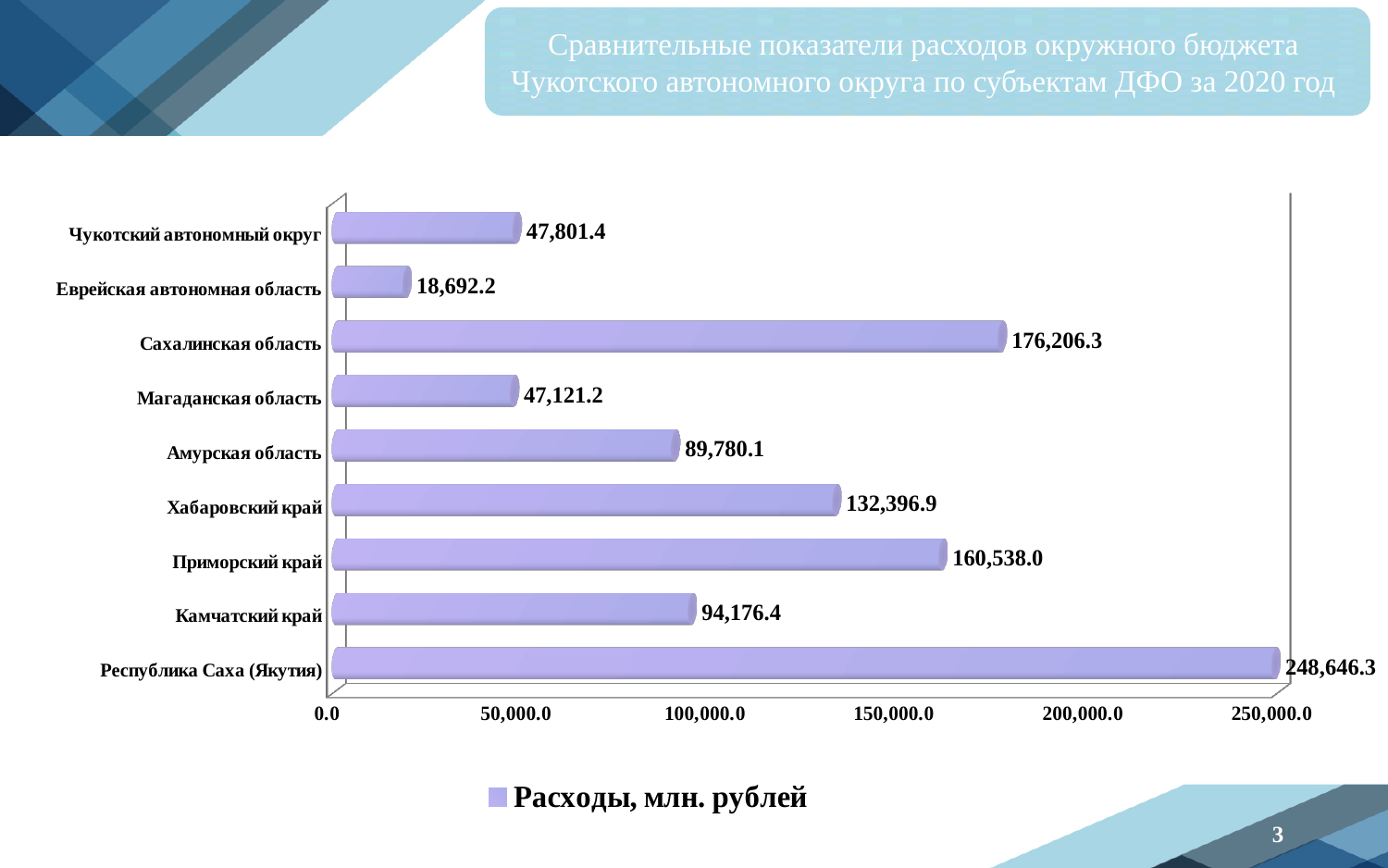
What is the difference between the values for Сахалинская область and Приморский край? 15,668.3 What is the value for Чукотский автономный округ? 47,801.4 Is the value for Хабаровский край greater or less than 100,000.0? greater Which category has the highest value? Республика Саха (Якутия) What is the value for Хабаровский край? 132,396.9 Which is larger, the value for Камчатский край or the value for Амурская область? Камчатский край What is the difference between the values for Республика Саха (Якутия) and Еврейская автономная область? 229,954.1 What kind of chart is shown on the slide? bar chart How many categories are shown in the chart? 9 What is the value for Сахалинская область? 176,206.3 What is the legend entry for the series shown in the chart? Расходы, млн. рублей Which category has the lowest value? Еврейская автономная область